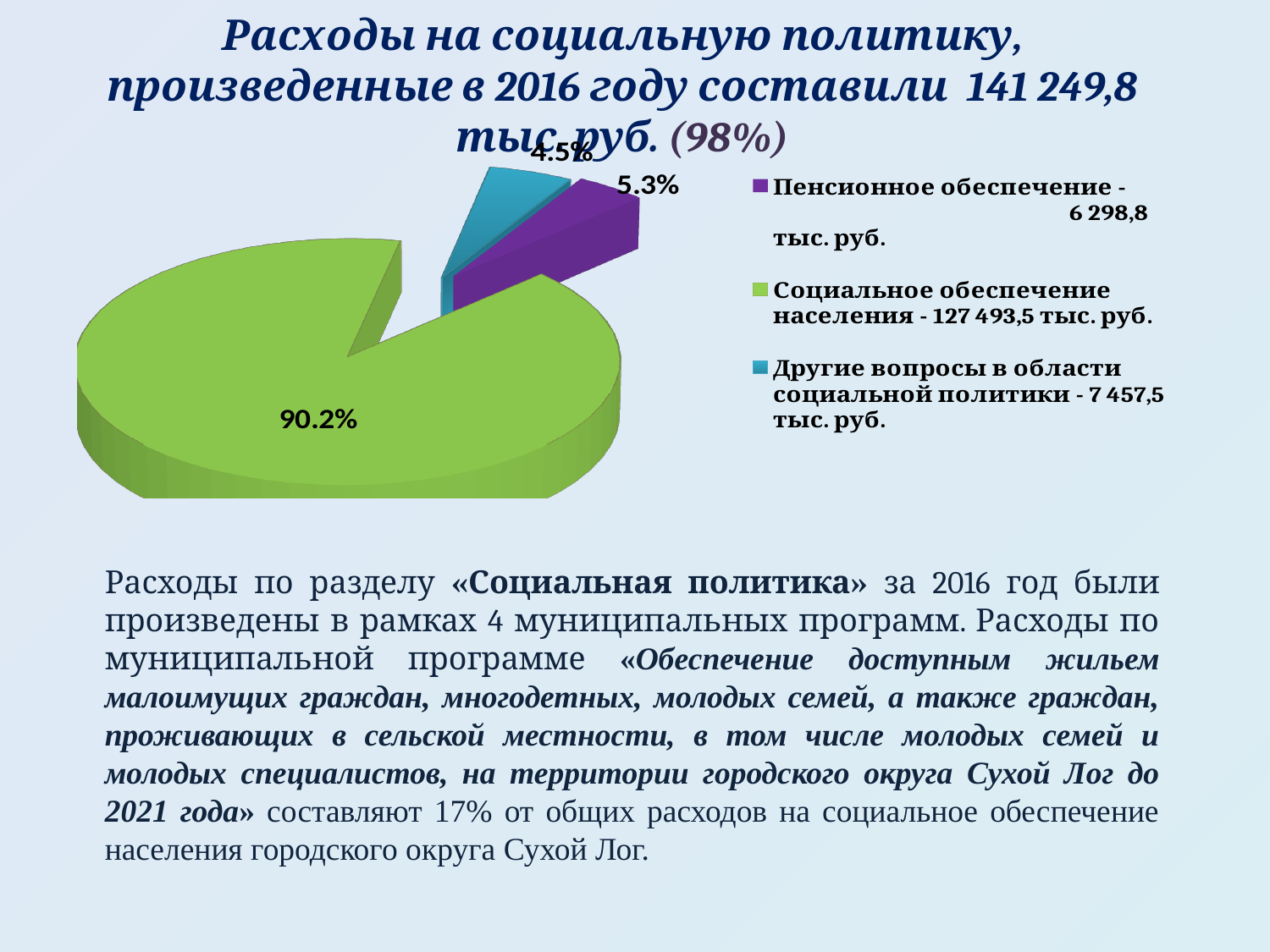
How many entries does the legend of the pie chart list? 3 What kind of chart is shown on the slide? pie chart Which category has the largest slice in the pie chart? Социальное обеспечение населения Which is larger according to the legend: Пенсионное обеспечение or Другие вопросы в области социальной политики? Другие вопросы в области социальной политики How many slices does the pie chart have? 3 What percentage label is shown on the largest slice of the pie chart? 90.2% What colour is the slice for Социальное обеспечение населения? green Which category has the smallest value according to the legend? Пенсионное обеспечение According to the legend, what is the value for Другие вопросы в области социальной политики? 7 457,5 тыс. руб. What is the difference between the legend values for Другие вопросы в области социальной политики and Пенсионное обеспечение? 1 158,7 тыс. руб. According to the legend, what is the value for Социальное обеспечение населения? 127 493,5 тыс. руб. According to the legend, what is the value for Пенсионное обеспечение? 6 298,8 тыс. руб.